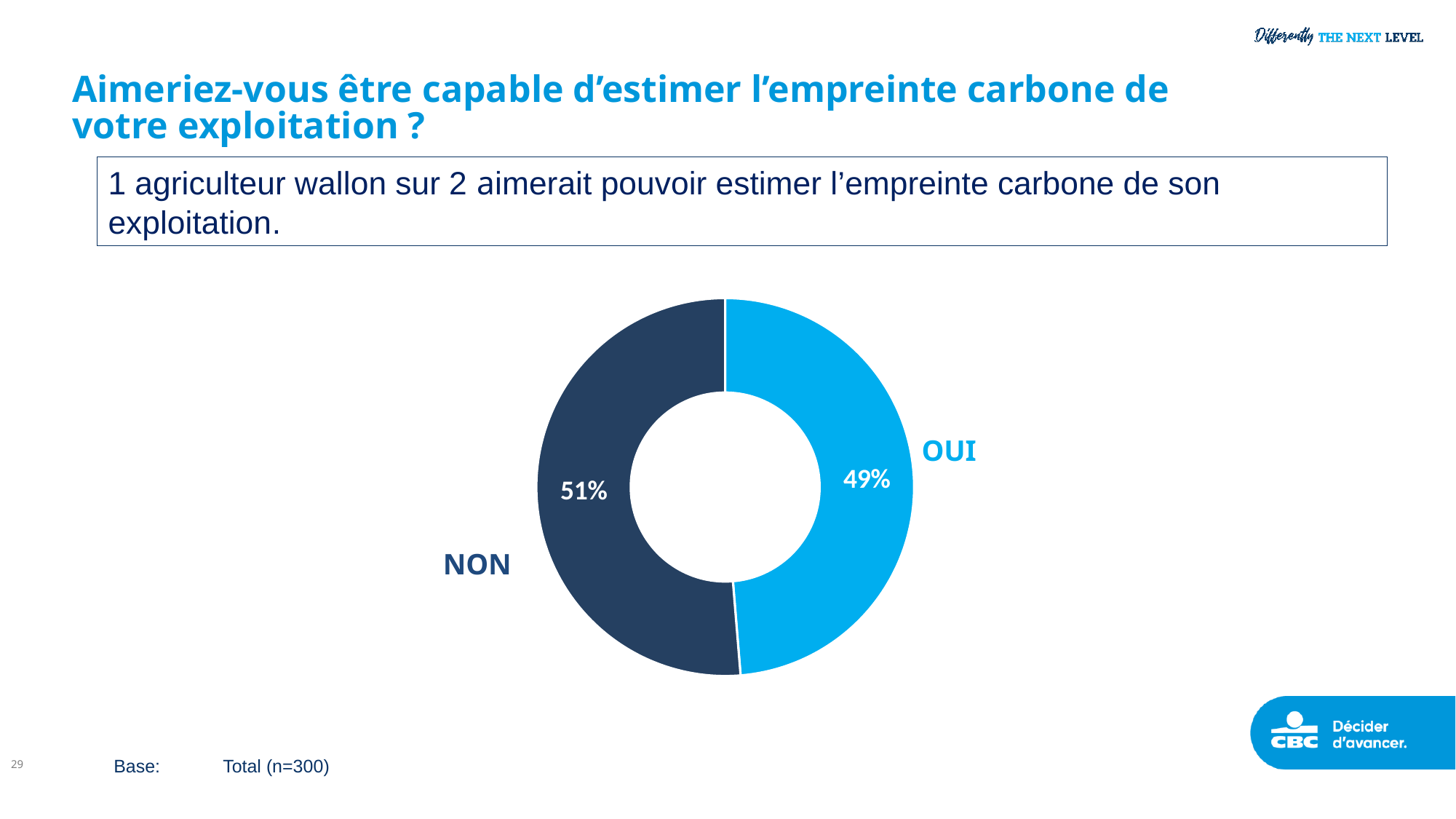
What is the base (sample size) stated for the chart? Total (n=300) What colour is the OUI segment of the chart? Light blue What kind of chart is shown on the slide? Doughnut chart Which category has the largest share of the chart? NON Which response has the larger share, OUI or NON? NON How many categories are shown in the chart? 2 What is the difference in percentage points between NON and OUI? 2 percentage points Which category has the smallest share of the chart? OUI What percentage of respondents answered OUI? 49% What percentage of respondents answered NON? 51% What is the combined share of OUI and NON? 100%